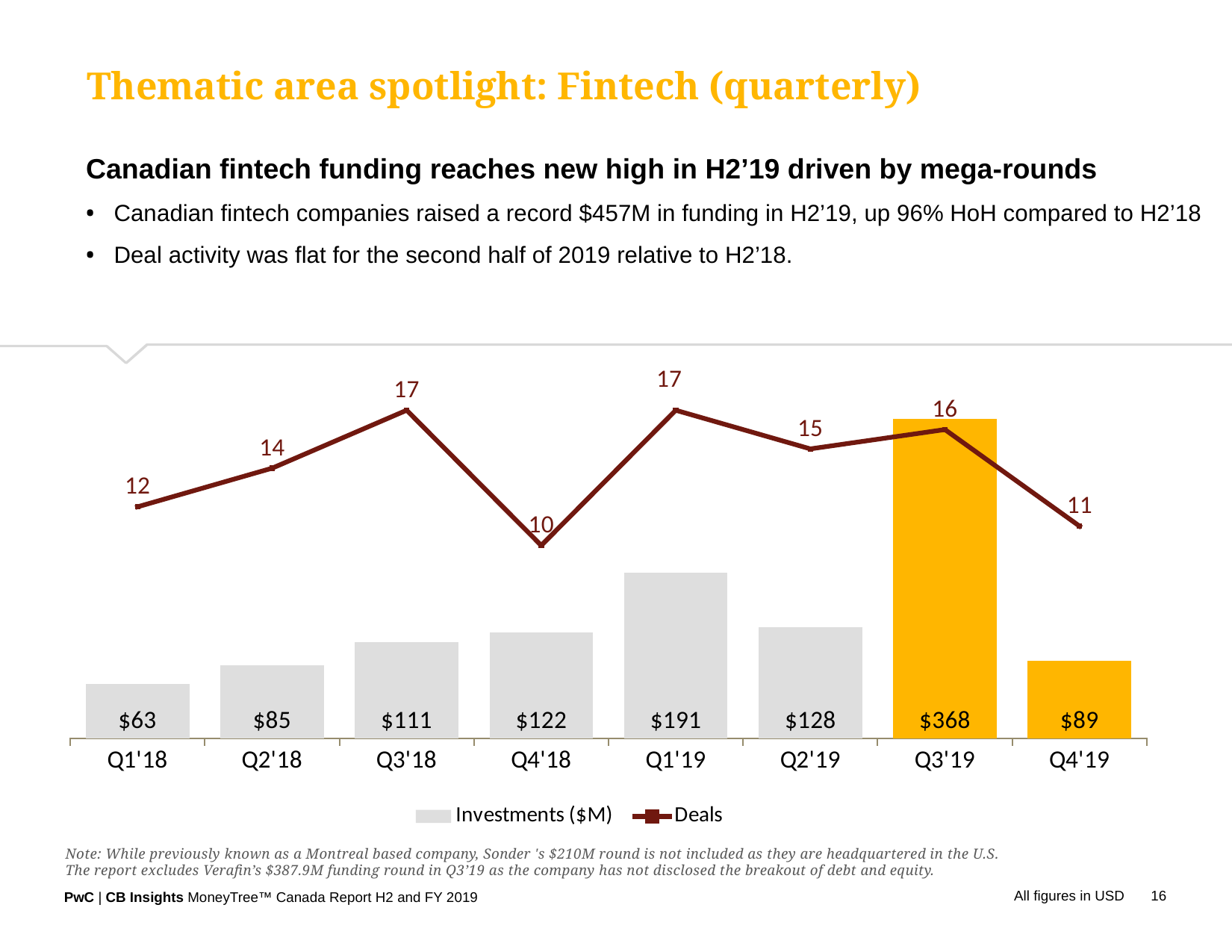
Which quarter had the highest investment amount? Q3'19 Which quarter had the lowest investment amount? Q1'18 How many deals were there in Q4'18? 10 Did the number of deals rise or fall from Q3'19 to Q4'19? Fall How many series does the legend list? 2 What is the total investment across Q3'19 and Q4'19? $457 What is the difference in investments between Q3'19 and Q4'19? $279 How many quarters are shown on the x axis? 8 Which quarter had more deals, Q2'18 or Q2'19? Q2'19 What kind of chart is used to show the Investments ($M) series? Bar chart Which quarter had the fewest deals? Q4'18 What was the investment amount in Q3'19? $368